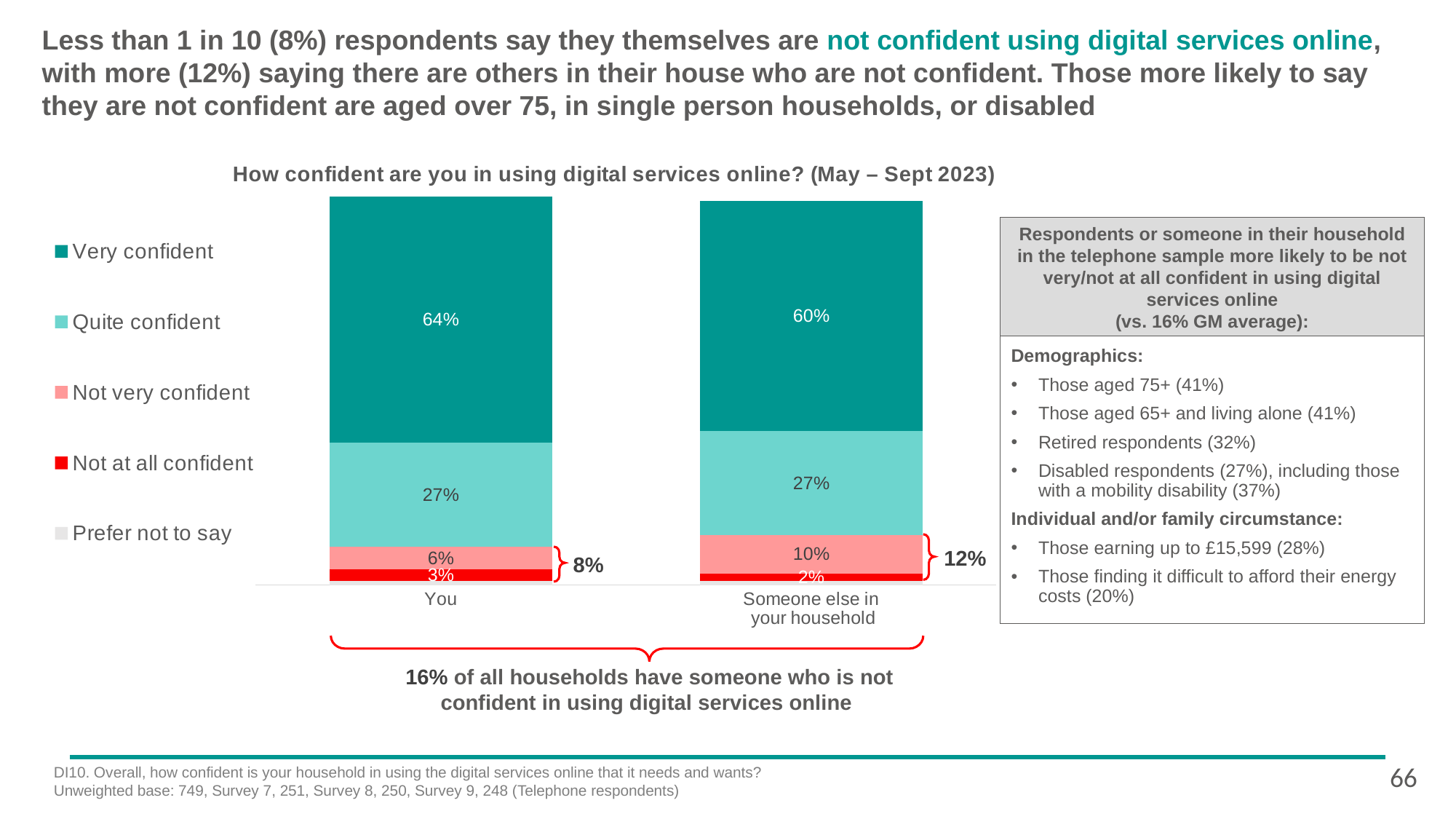
How many series does the chart legend list? 5 What is the 'Not at all confident' value for the 'You' bar? 3% Which bar has the higher 'Very confident' value, 'You' or 'Someone else in your household'? You What percentage say someone else in their household is very confident in using digital services online? 60% What percentage of respondents say they themselves are very confident in using digital services online? 64% What is the 'Not very confident' value for the 'Someone else in your household' bar? 10% How many bars (categories) are shown in the chart? 2 What is the combined share of 'Not very confident' and 'Not at all confident' for the 'You' bar, as annotated on the chart? 8% What is the combined share of 'Not very confident' and 'Not at all confident' for the 'Someone else in your household' bar, as annotated on the chart? 12% What type of chart is shown on the slide? Stacked bar chart What is the 'Quite confident' value for the 'You' bar? 27% What is the difference between the 'Not very confident' values for 'Someone else in your household' and 'You'? 4%